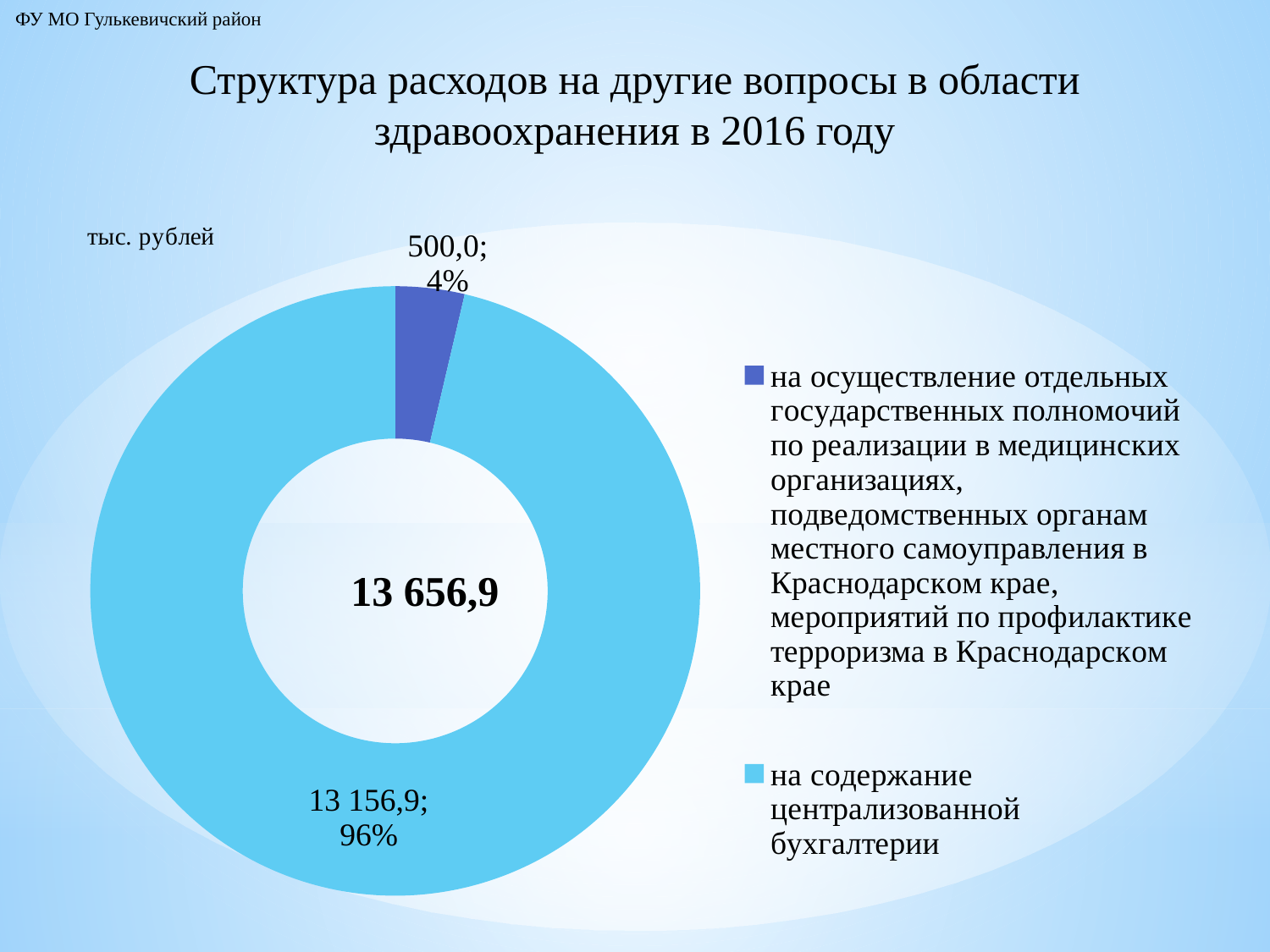
What is the value for 'на осуществление отдельных государственных полномочий по реализации в медицинских организациях...'? 500,0 Which is larger: the value for 'на содержание централизованной бухгалтерии' or the value for 'на осуществление отдельных государственных полномочий...'? на содержание централизованной бухгалтерии What share of the chart does 'на содержание централизованной бухгалтерии' represent? 96% What is the difference between the value for 'на содержание централизованной бухгалтерии' and the value for 'на осуществление отдельных государственных полномочий...'? 12 656,9 How many categories does the chart show? 2 What type of chart is shown on the slide? doughnut (pie) chart In what units are the chart values given? тыс. рублей Which category has the largest value? на содержание централизованной бухгалтерии What is the value for 'на содержание централизованной бухгалтерии'? 13 156,9 What share of the chart does the slice for 'на осуществление отдельных государственных полномочий...' represent? 4% What total value is shown in the centre of the doughnut chart? 13 656,9